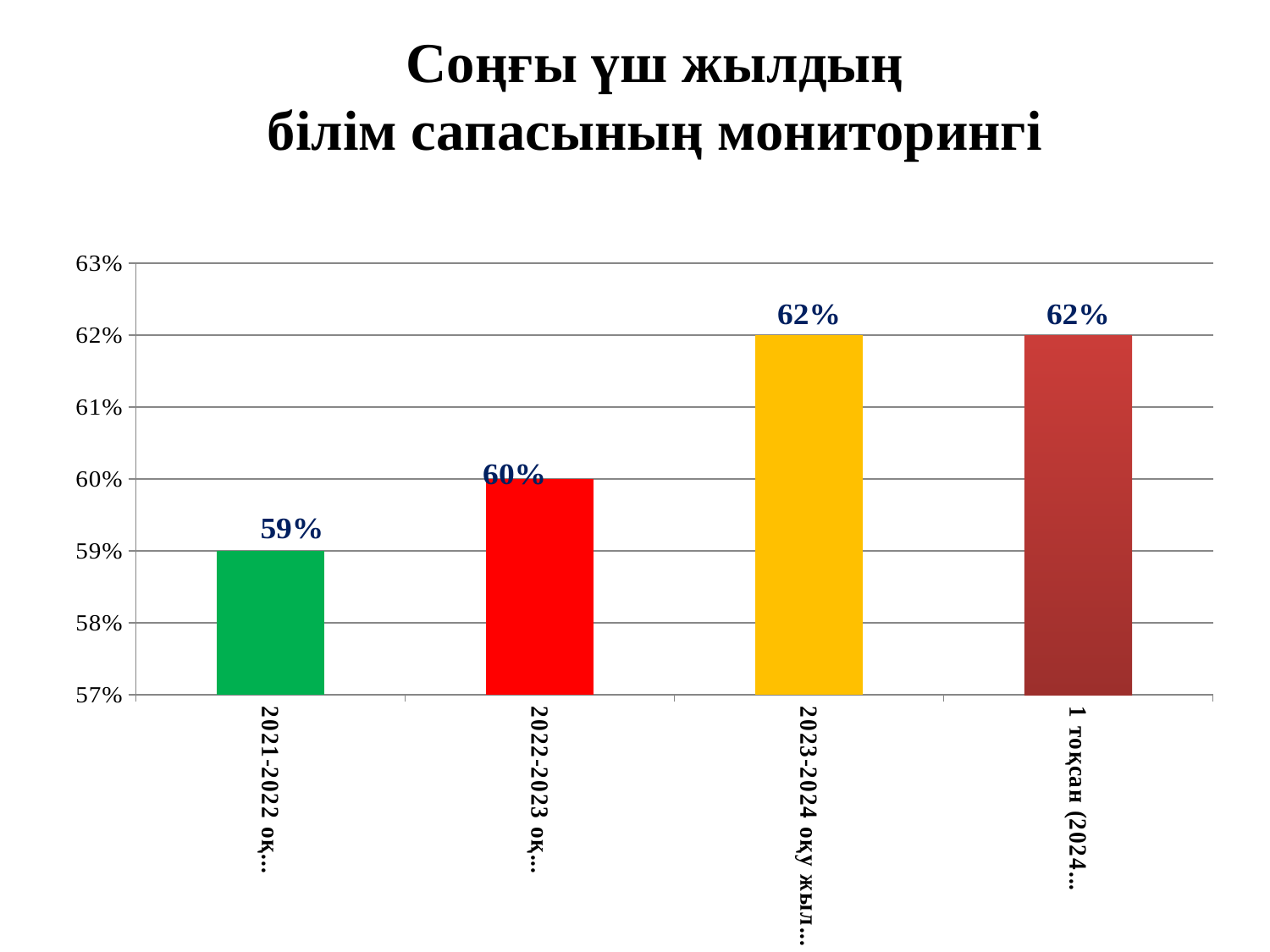
What is the value for 2023-2024? 62% What is the difference between the values for 2023-2024 and 2021-2022? 3% What is the value for 2021-2022? 59% What is the value for 2022-2023? 60% Which is larger, the value for 2022-2023 or the value for 2023-2024? 2023-2024 What kind of chart is shown on the slide? bar chart What is the difference between the values for 2022-2023 and 2021-2022? 1% Is the value for 2022-2023 greater or less than 61%? less Which category has the lowest value? 2021-2022 Do the values rise or fall from 2021-2022 to 2023-2024? rise How many bars are shown in the chart? 4 What is the value for the bar labelled 1 тоқсан (2024...)? 62%